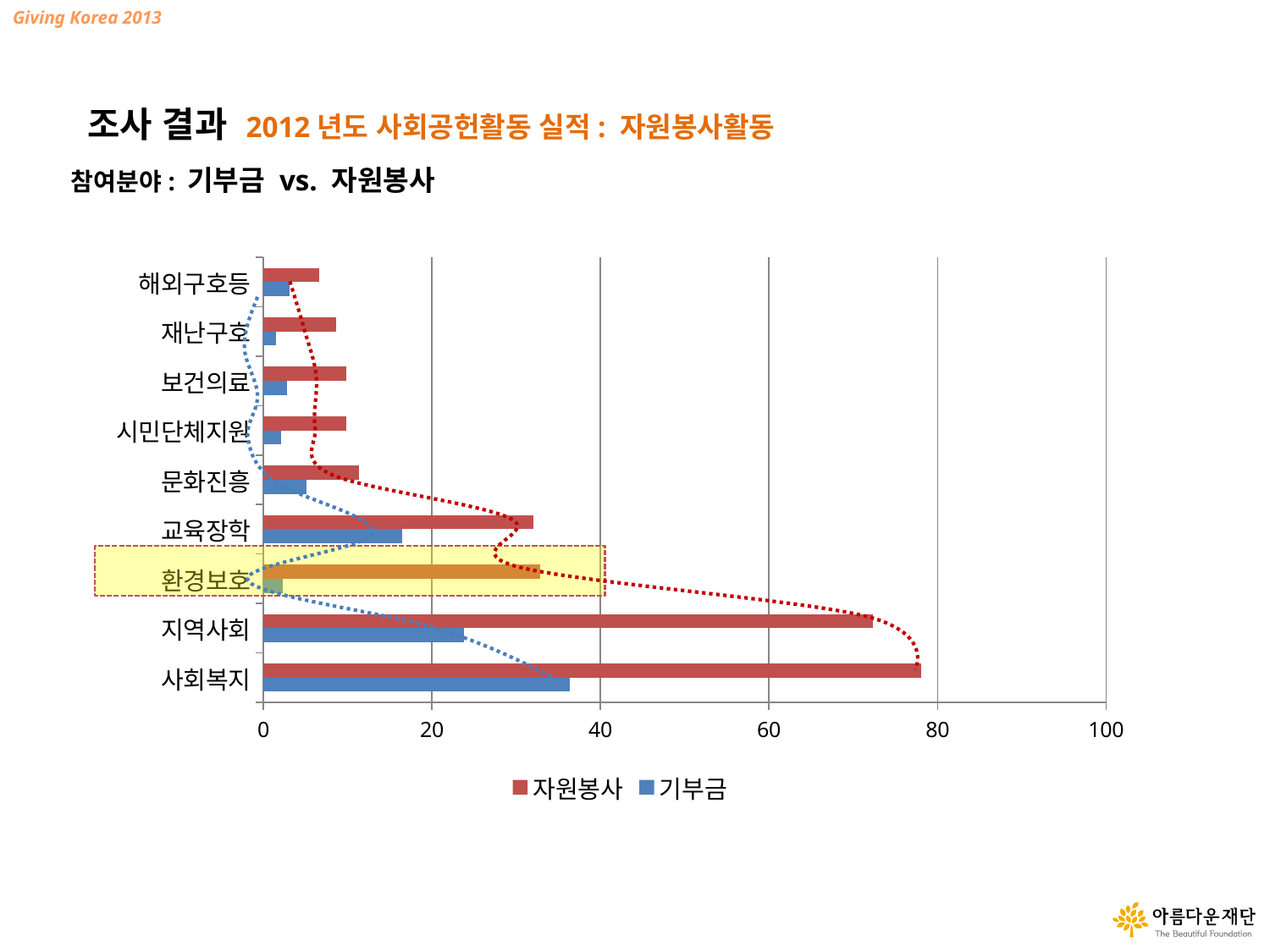
How many series does the legend list? 2 Is the 자원봉사 value for 사회복지 greater or less than 60? greater Which category has the highest 자원봉사 value? 사회복지 Is the 기부금 value for 환경보호 greater or less than 20? less For 교육장학, which is larger: 자원봉사 or 기부금? 자원봉사 Which category is highlighted with a yellow box on the chart? 환경보호 Is the 자원봉사 value for 지역사회 greater or less than 60? greater For 환경보호, which is larger: 자원봉사 or 기부금? 자원봉사 What kind of chart is shown on the slide? bar chart Which category has the highest 기부금 value? 사회복지 How many categories are shown on the vertical axis of the chart? 9